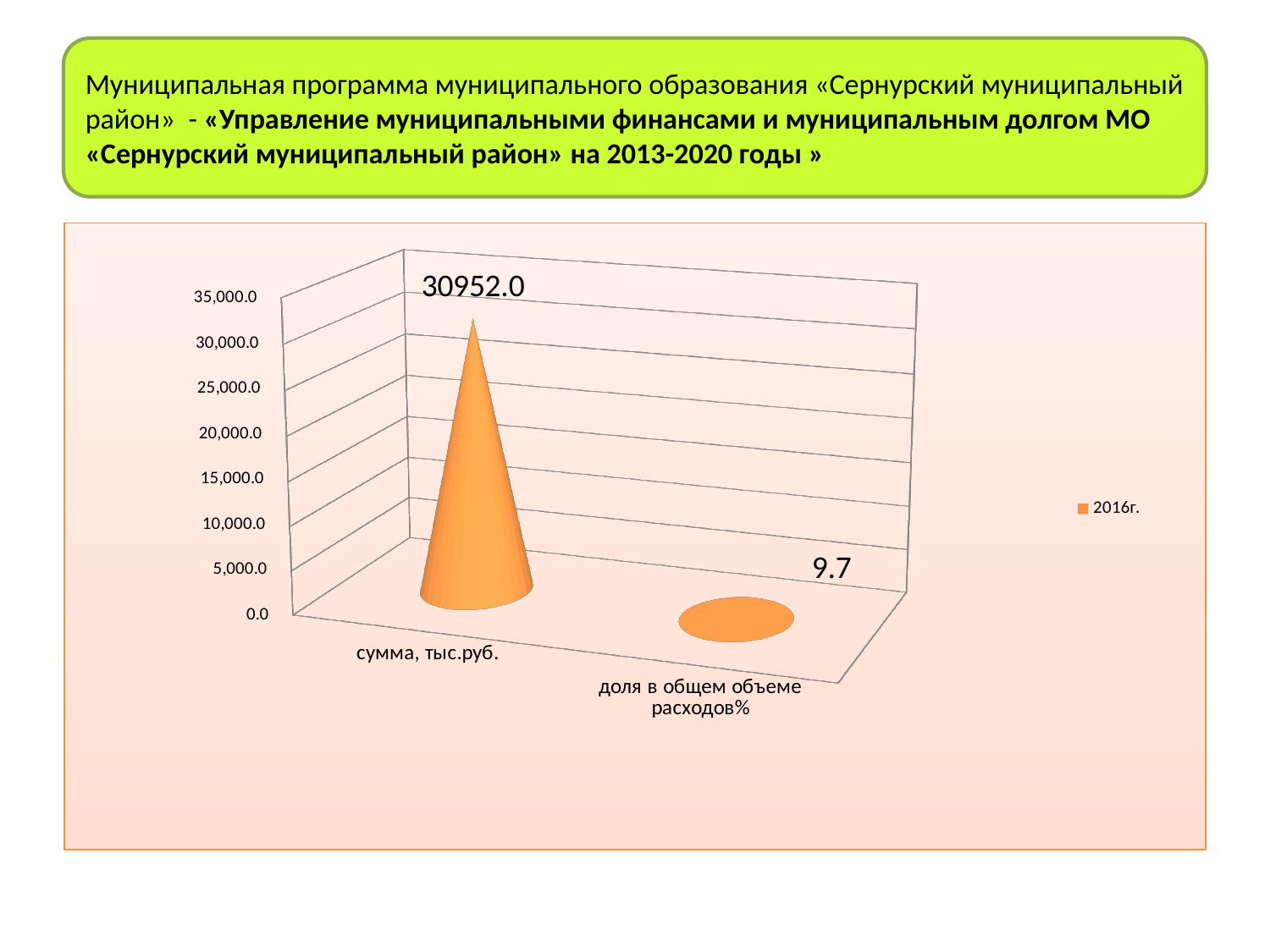
What is the value for «доля в общем объеме расходов%» on the chart? 9.7 What is the legend entry shown on the chart? 2016г. Which category has the highest value on the chart? сумма, тыс.руб. What is the difference between the value for «сумма, тыс.руб.» and the value for «доля в общем объеме расходов%»? 30942.3 Is the value for «сумма, тыс.руб.» greater or less than 25,000.0? greater How many series does the legend list? 1 Is the value for «доля в общем объеме расходов%» greater or less than 5,000.0? less Which category has the lowest value on the chart? доля в общем объеме расходов% What is the value for «сумма, тыс.руб.» on the chart? 30952.0 What kind of chart is shown on the slide? bar chart Which is larger: the value for «сумма, тыс.руб.» or the value for «доля в общем объеме расходов%»? сумма, тыс.руб. How many categories are shown on the chart? 2